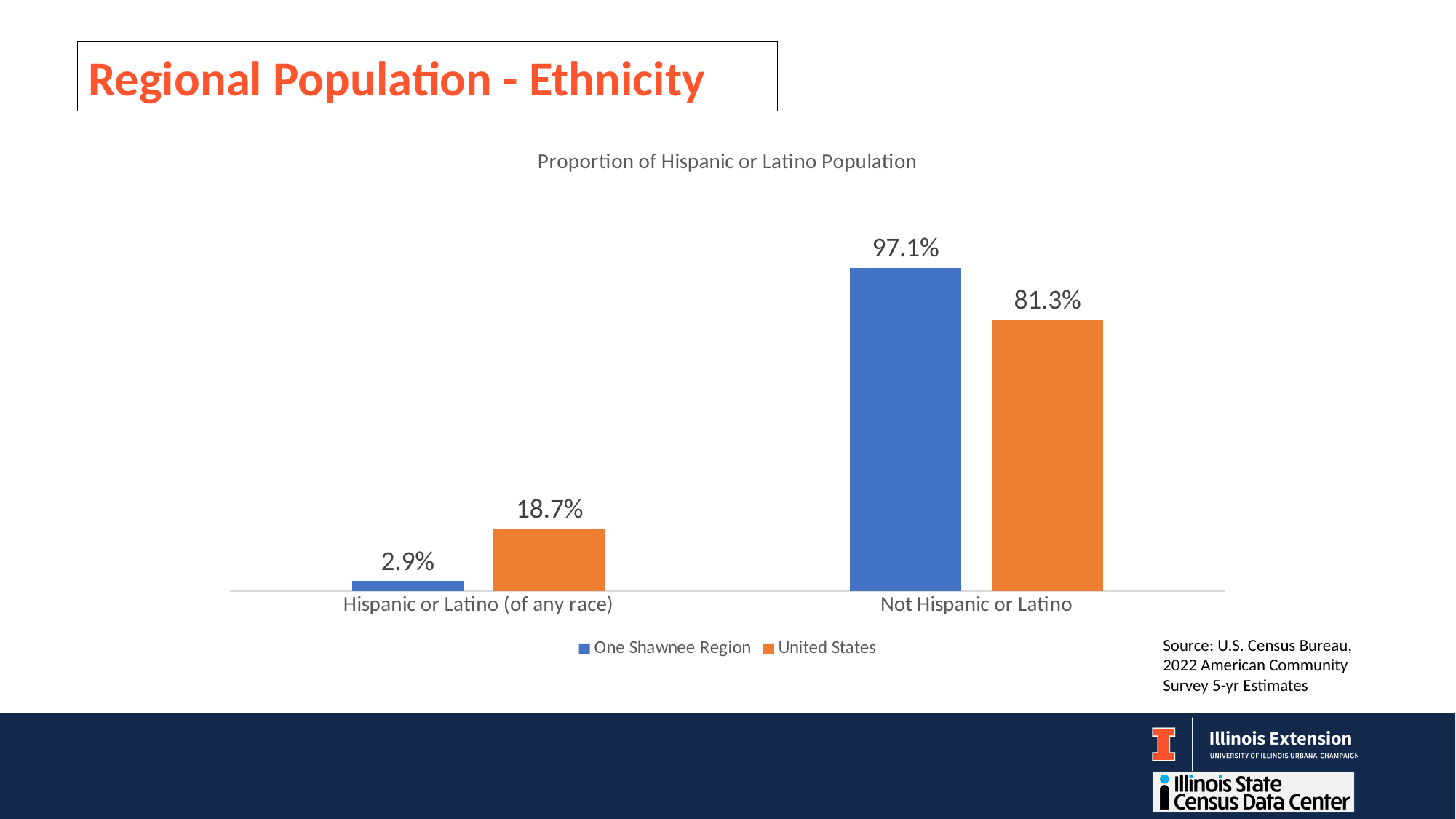
What is the difference between the United States and One Shawnee Region values in the Hispanic or Latino (of any race) category? 15.8% Which category has the highest value for One Shawnee Region? Not Hispanic or Latino In the Not Hispanic or Latino category, which series has the larger value, One Shawnee Region or United States? One Shawnee Region What is the value for United States in the Hispanic or Latino (of any race) category? 18.7% How many series does the legend list? 2 What is the difference between the One Shawnee Region and United States values in the Not Hispanic or Latino category? 15.8% What kind of chart is shown on the slide? Bar chart How many categories are shown on the x axis? 2 What is the value for One Shawnee Region in the Hispanic or Latino (of any race) category? 2.9% Which category has the lowest value for United States? Hispanic or Latino (of any race) What is the value for United States in the Not Hispanic or Latino category? 81.3% What is the value for One Shawnee Region in the Not Hispanic or Latino category? 97.1%